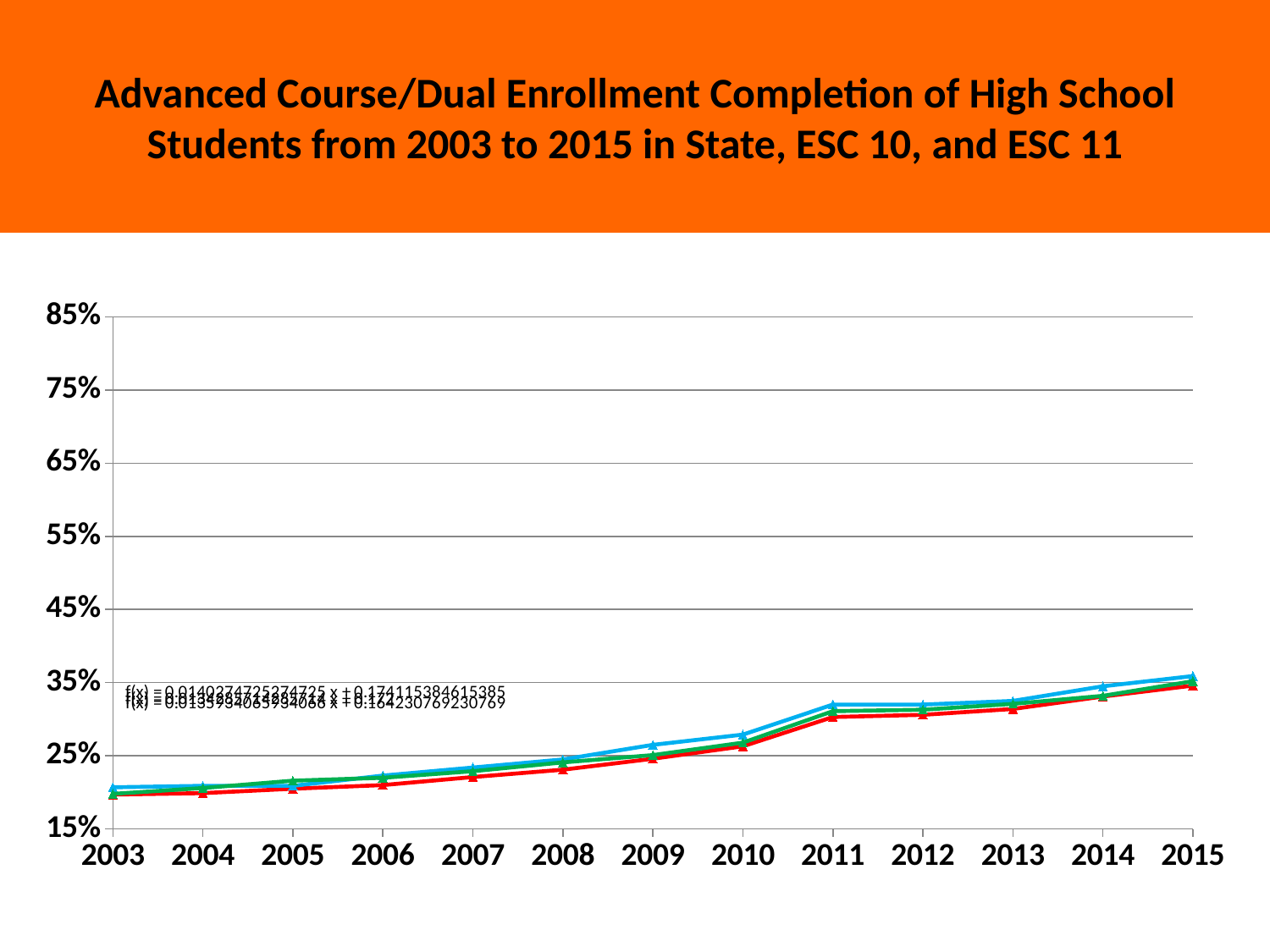
What is the title of the chart? Advanced Course/Dual Enrollment Completion of High School Students from 2003 to 2015 in State, ESC 10, and ESC 11 In 2010, which is higher, the blue line or the red line? blue line Is the value of the blue line in 2003 greater or less than 25%? less Is the value of the blue line in 2011 greater or less than 35%? less What kind of chart is shown on the slide? line chart Do the plotted values generally rise or fall from 2003 to 2015? rise Is the value of the red line in 2008 greater or less than 25%? less What is the highest value labelled on the y axis? 85% How many lines are plotted on the chart? 3 How many years are shown along the x axis of the chart? 13